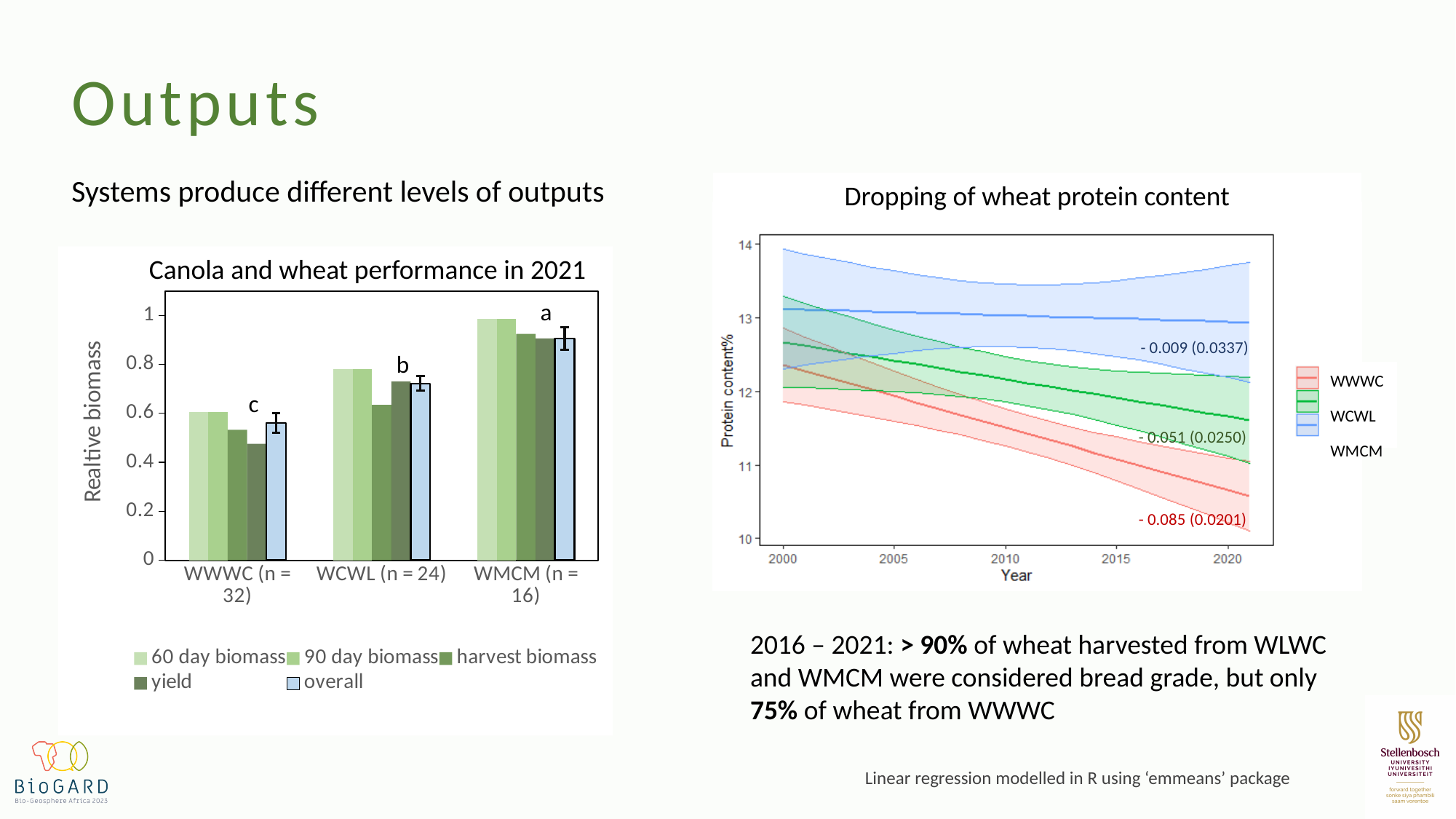
In the 'Canola and wheat performance in 2021' chart, which category has the lowest overall relative biomass? WWWC (n = 32) In the 'Dropping of wheat protein content' chart, does the WWWC protein content rise or fall from 2000 to 2020? fall What kind of chart is 'Canola and wheat performance in 2021'? bar chart In the 'Canola and wheat performance in 2021' chart, how many series does the legend list? 5 In the 'Canola and wheat performance in 2021' chart, is the yield value for WWWC (n = 32) greater or less than 0.6? less In the 'Canola and wheat performance in 2021' chart, which is larger: the 60 day biomass for WCWL (n = 24) or the 60 day biomass for WWWC (n = 32)? WCWL (n = 24) In the 'Canola and wheat performance in 2021' chart, which category has the highest overall relative biomass? WMCM (n = 16) In the 'Dropping of wheat protein content' chart, what slope value is printed for the WMCM line? - 0.009 (0.0337) In the 'Dropping of wheat protein content' chart, how many series does the legend list? 3 In the 'Canola and wheat performance in 2021' chart, how many categories are shown on the x axis? 3 In the 'Dropping of wheat protein content' chart, what slope value is printed for the WWWC line? - 0.085 (0.0201) In the 'Canola and wheat performance in 2021' chart, is the 60 day biomass value for WMCM (n = 16) greater or less than 0.8? greater